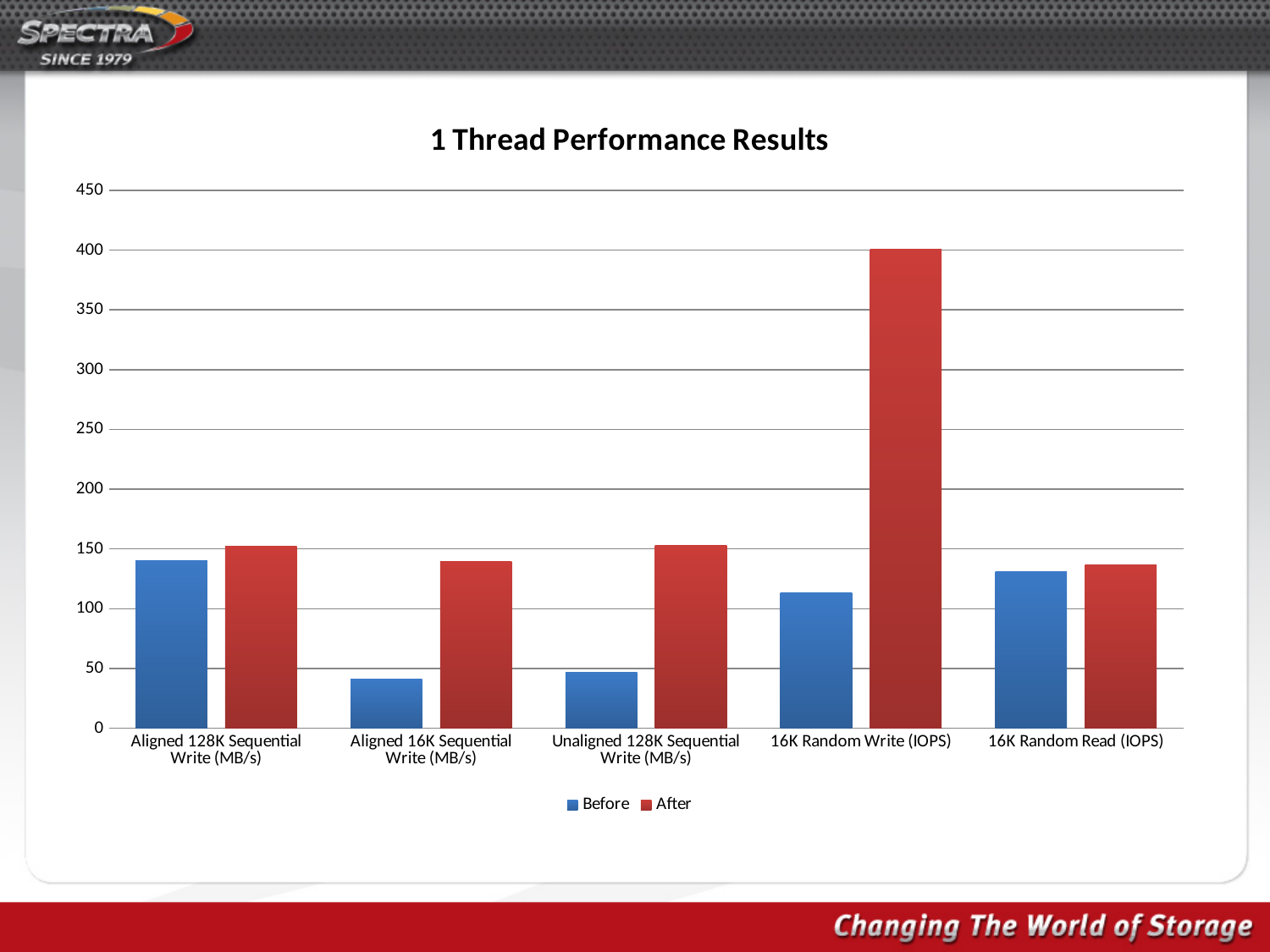
For Aligned 16K Sequential Write (MB/s), which is larger, the Before value or the After value? After Which is larger, the Before value for Aligned 128K Sequential Write (MB/s) or the Before value for Unaligned 128K Sequential Write (MB/s)? Aligned 128K Sequential Write (MB/s) How many series does the legend list? 2 How many categories are shown on the x axis? 5 Which category has the highest After value? 16K Random Write (IOPS) Which colour represents the After series in the chart? red Is the Before value for 16K Random Write (IOPS) greater or less than 100? greater Is the Before value for Aligned 16K Sequential Write (MB/s) greater or less than 50? less Is the After value for Unaligned 128K Sequential Write (MB/s) greater or less than 100? greater What type of chart is shown on the slide? bar chart What is the title of the chart? 1 Thread Performance Results